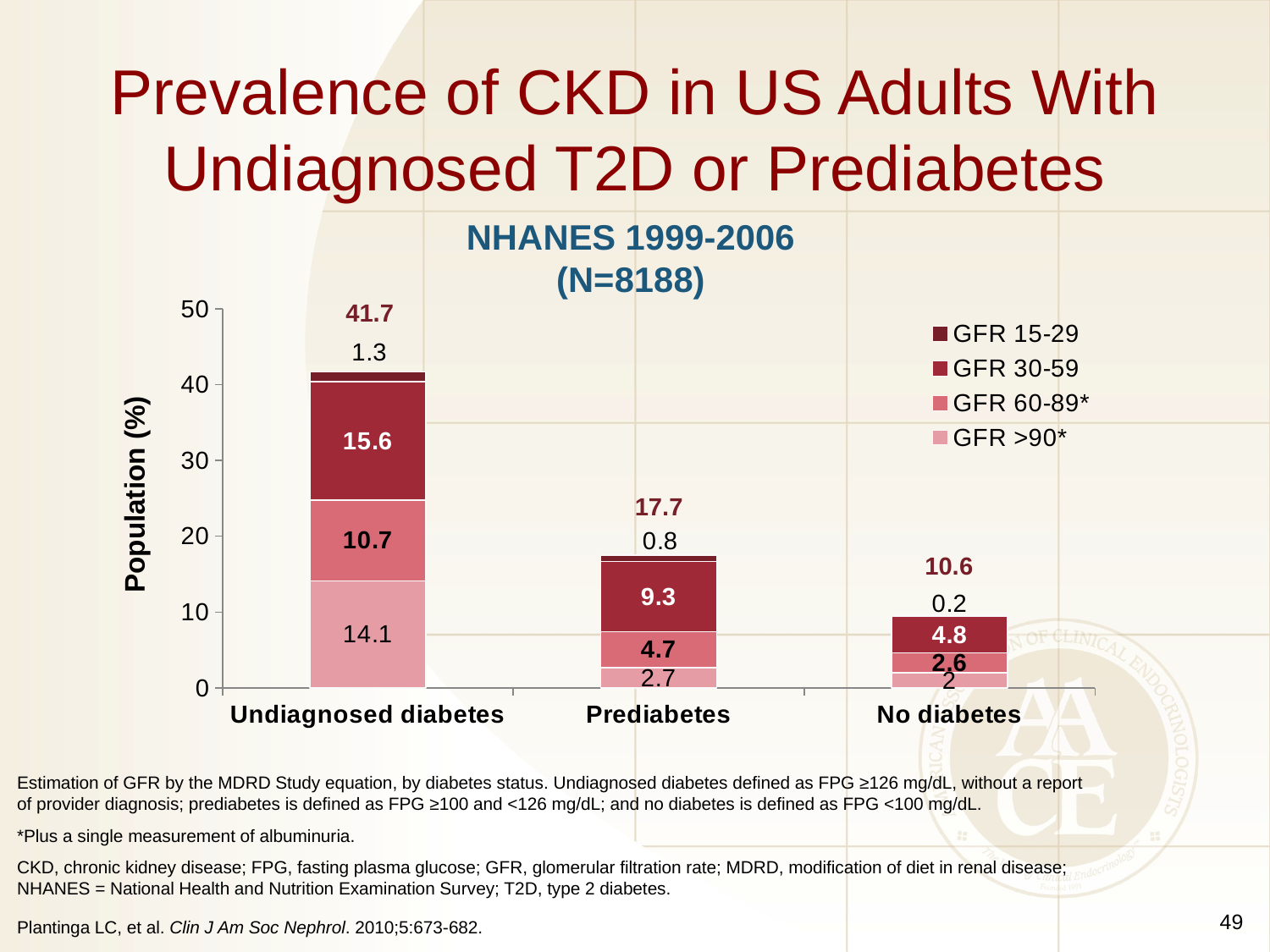
What is the difference between the GFR 30-59 values for Undiagnosed diabetes and Prediabetes? 6.3 What is the GFR >90* value for Prediabetes? 2.7 How many categories are shown on the x axis? 3 What is the GFR 60-89* value for Undiagnosed diabetes? 10.7 What is the GFR 30-59 value for Undiagnosed diabetes? 15.6 Which is larger, the GFR 60-89* value for Prediabetes or for No diabetes? Prediabetes What type of chart is shown on the slide? Stacked bar chart Which category has the lowest total printed above its bar? No diabetes What is the GFR 15-29 value for No diabetes? 0.2 How many series does the legend list? 4 What total is printed above the Undiagnosed diabetes bar? 41.7 Which category has the highest total printed above its bar? Undiagnosed diabetes